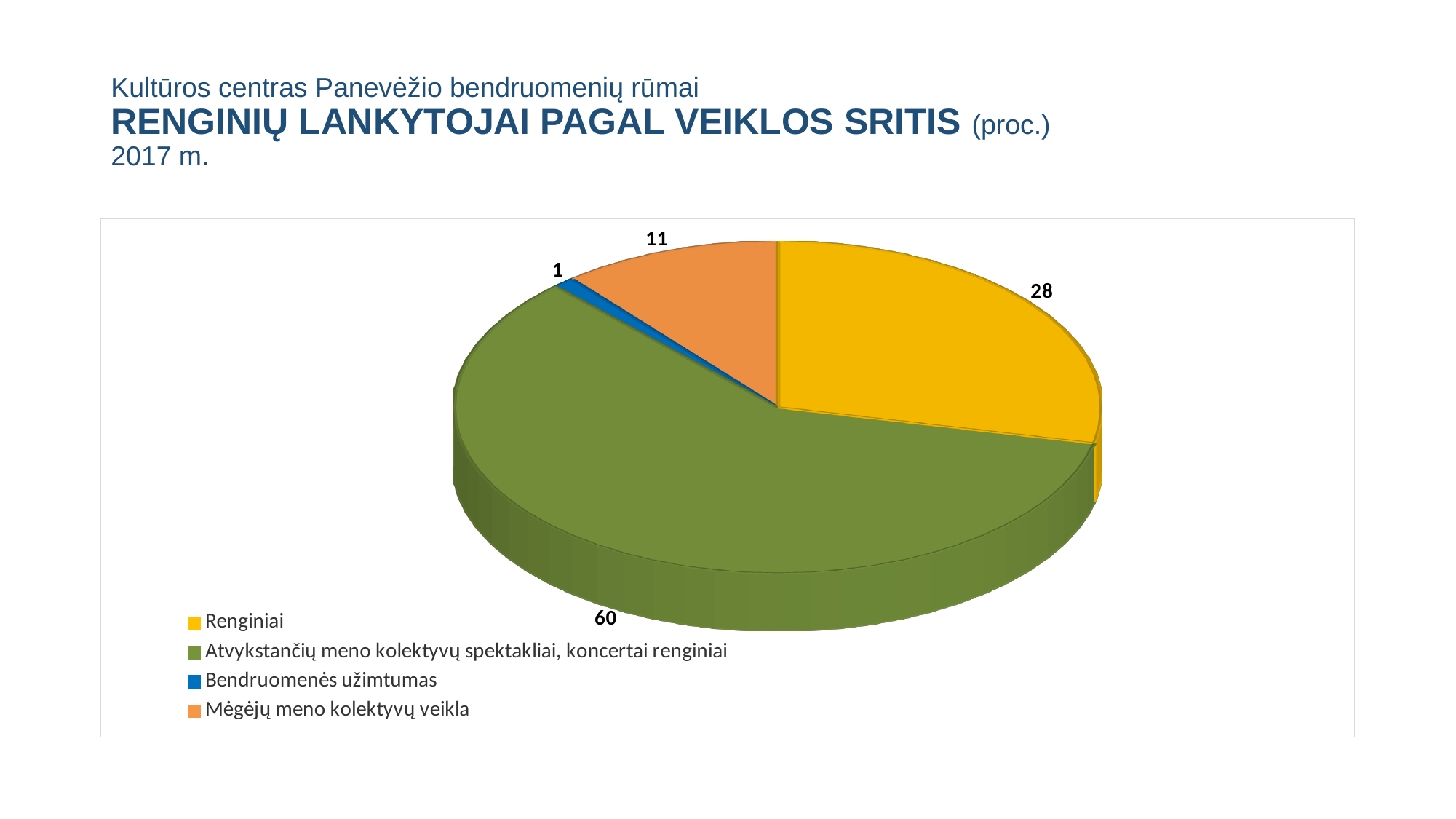
What is the value for Mėgėjų meno kolektyvų veikla? 11 Which category has the largest slice? Atvykstančių meno kolektyvų spektakliai, koncertai renginiai What is the difference between the values for Atvykstančių meno kolektyvų spektakliai, koncertai renginiai and Renginiai? 32 What year does the chart title refer to? 2017 m. What kind of chart is shown on the slide? pie chart What is the value for Bendruomenės užimtumas? 1 What colour is the slice for Bendruomenės užimtumas? blue What is the value for Atvykstančių meno kolektyvų spektakliai, koncertai renginiai? 60 What is the value for Renginiai? 28 Which is larger, the value for Renginiai or the value for Mėgėjų meno kolektyvų veikla? Renginiai How many categories does the pie chart show? 4 Which category has the smallest slice? Bendruomenės užimtumas